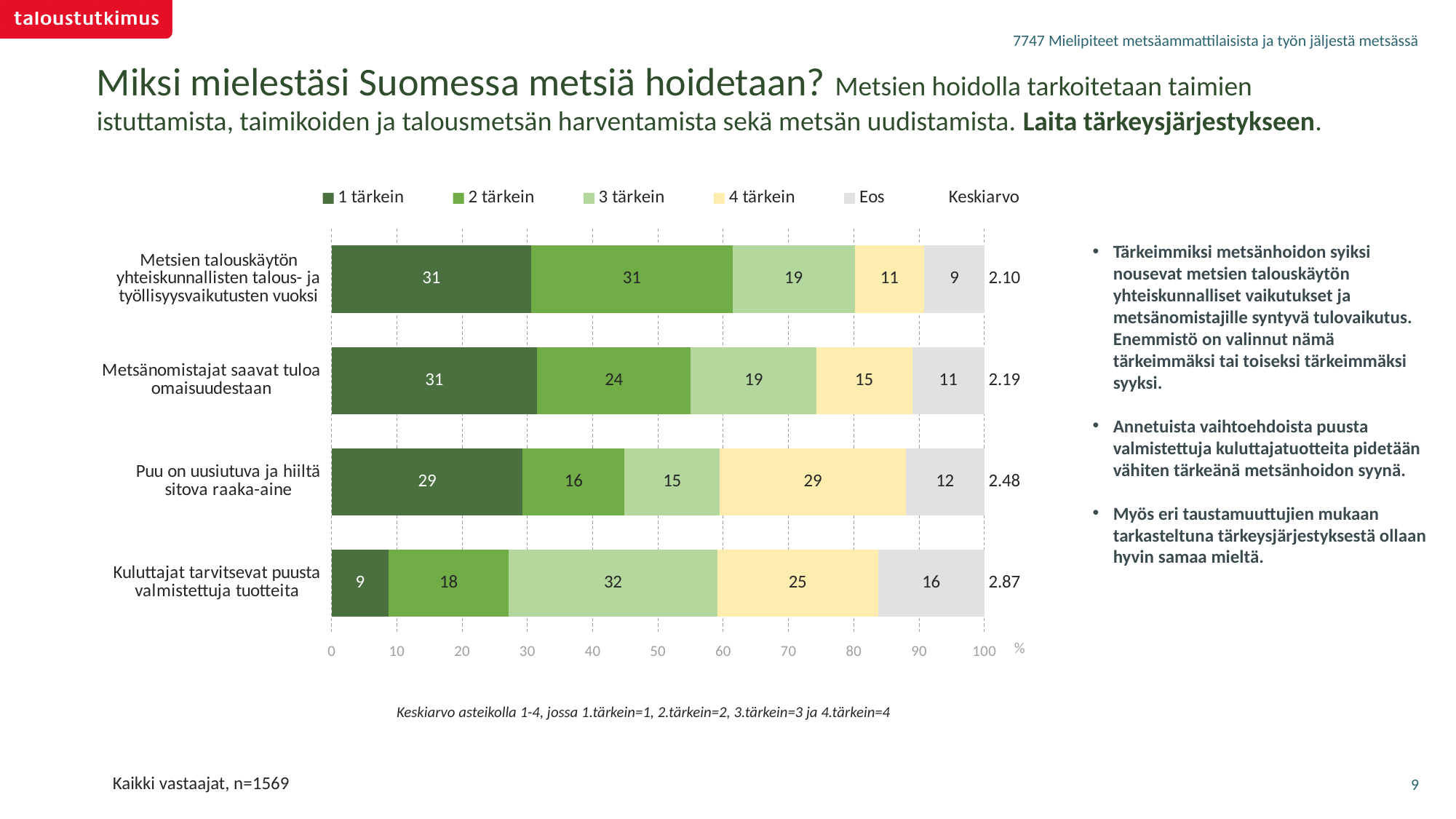
What type of chart is shown on the slide? Stacked bar chart How many categories (reasons) are shown on the chart? 4 Which is larger: the '4 tärkein' value for 'Metsänomistajat saavat tuloa omaisuudestaan' or for 'Kuluttajat tarvitsevat puusta valmistettuja tuotteita'? Kuluttajat tarvitsevat puusta valmistettuja tuotteita What is the total of the stacked bar for 'Metsänomistajat saavat tuloa omaisuudestaan'? 100 What is the '4 tärkein' value for 'Puu on uusiutuva ja hiiltä sitova raaka-aine'? 29 What is the difference between the '2 tärkein' values for 'Metsien talouskäytön yhteiskunnallisten talous- ja työllisyysvaikutusten vuoksi' and 'Metsänomistajat saavat tuloa omaisuudestaan'? 7 Which category has the highest '3 tärkein' value? Kuluttajat tarvitsevat puusta valmistettuja tuotteita What is the Keskiarvo value for 'Metsänomistajat saavat tuloa omaisuudestaan'? 2.19 Which category has the highest Keskiarvo value? Kuluttajat tarvitsevat puusta valmistettuja tuotteita What is the '1 tärkein' value for 'Kuluttajat tarvitsevat puusta valmistettuja tuotteita'? 9 Which category has the lowest Eos value? Metsien talouskäytön yhteiskunnallisten talous- ja työllisyysvaikutusten vuoksi How many colour-coded series does the legend list? 5